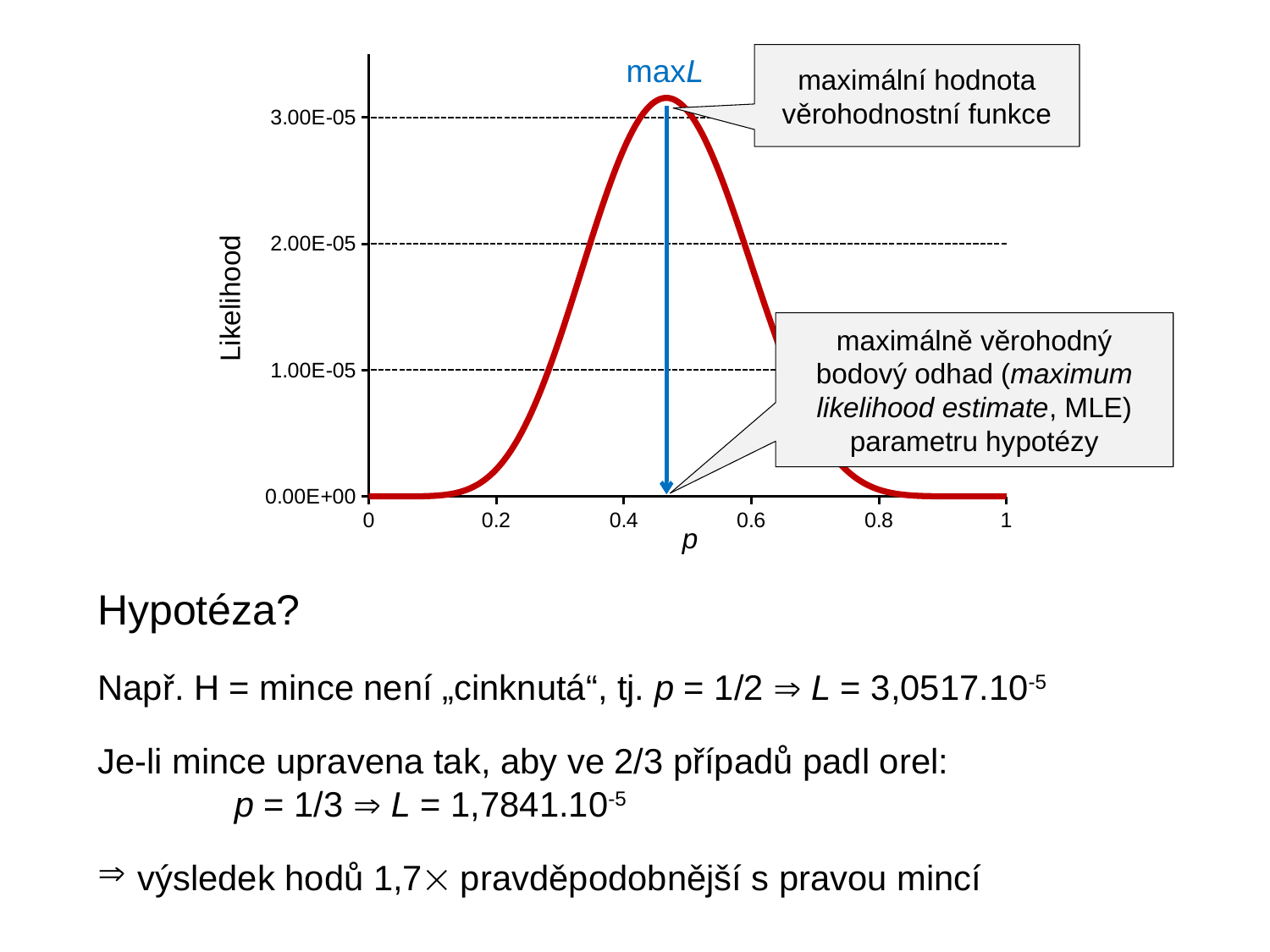
What kind of chart is shown on the slide? line chart Is the peak value of the curve greater or less than 2.00E-05? greater Is the value of the curve at p = 0.4 greater or less than 2.00E-05? greater Is the value of the curve at p = 0.2 greater or less than 1.00E-05? less Between which two labelled x-axis ticks does the curve reach its maximum? 0.4 and 0.6 What is the label of the vertical axis of the chart? Likelihood Does the curve rise or fall as p goes from 0.6 to 1? fall What is the label of the horizontal axis of the chart? p How many data series are plotted in the chart? 1 Does the curve rise or fall as p goes from 0 to 0.4? rise